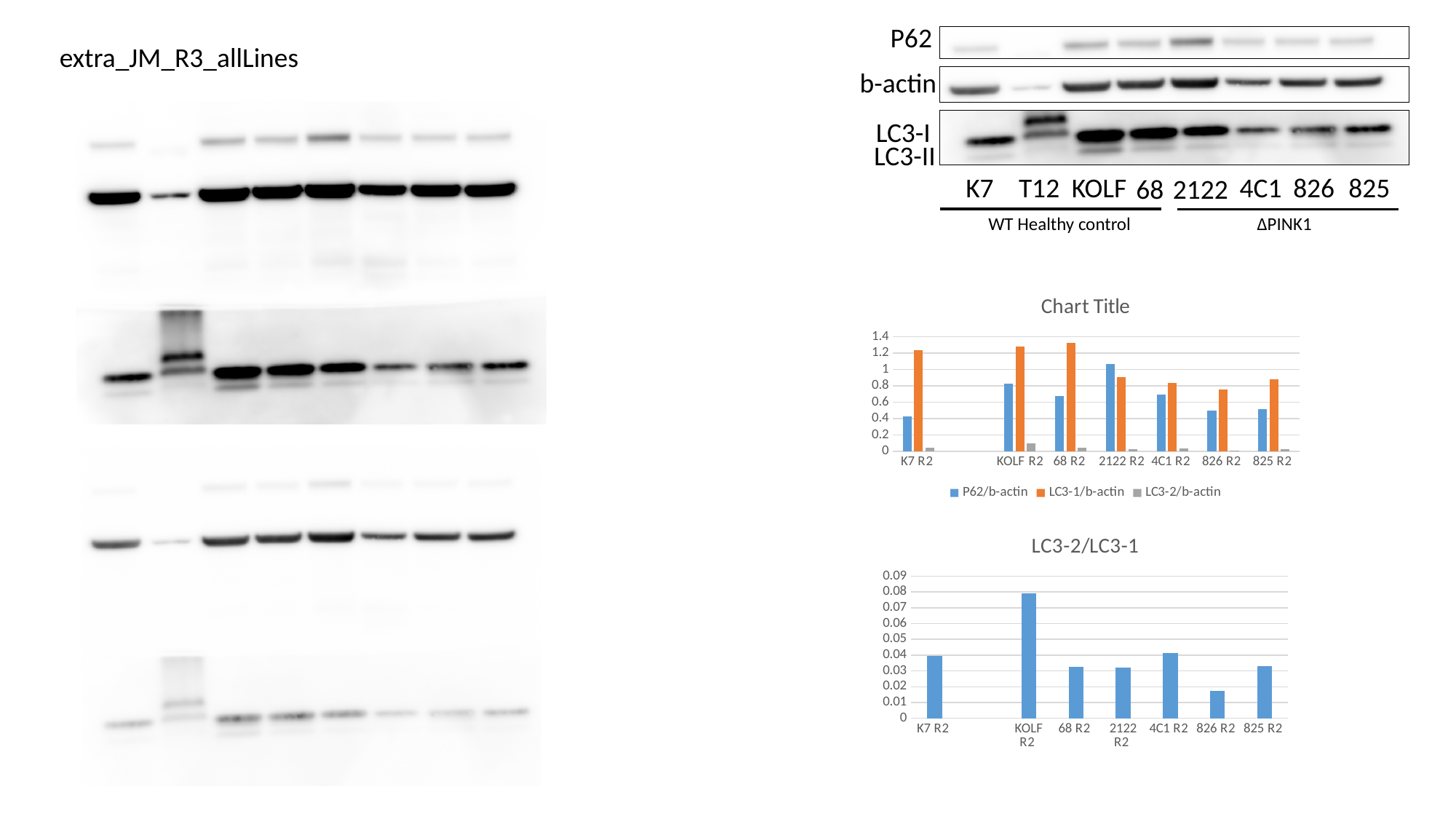
In the chart titled "Chart Title", is the P62/b-actin value for 2122 R2 greater or less than 1? greater What kind of chart is the LC3-2/LC3-1 chart? bar chart In the chart titled "Chart Title", which series is shown in orange? LC3-1/b-actin In the chart titled "Chart Title", which category has the highest LC3-2/b-actin value? KOLF R2 In the chart titled "Chart Title", which category has the lowest LC3-1/b-actin value? 826 R2 In the chart titled "Chart Title", which category has the highest P62/b-actin value? 2122 R2 In the LC3-2/LC3-1 chart, is the value for KOLF R2 greater or less than 0.07? greater In the chart titled "Chart Title", is the P62/b-actin value for 826 R2 greater or less than 0.6? less In the LC3-2/LC3-1 chart, which category has the highest value? KOLF R2 In the chart titled "Chart Title", how many series does the legend list? 3 In the LC3-2/LC3-1 chart, which category has the lowest value? 826 R2 In the chart titled "Chart Title", for K7 R2, which is larger: P62/b-actin or LC3-1/b-actin? LC3-1/b-actin